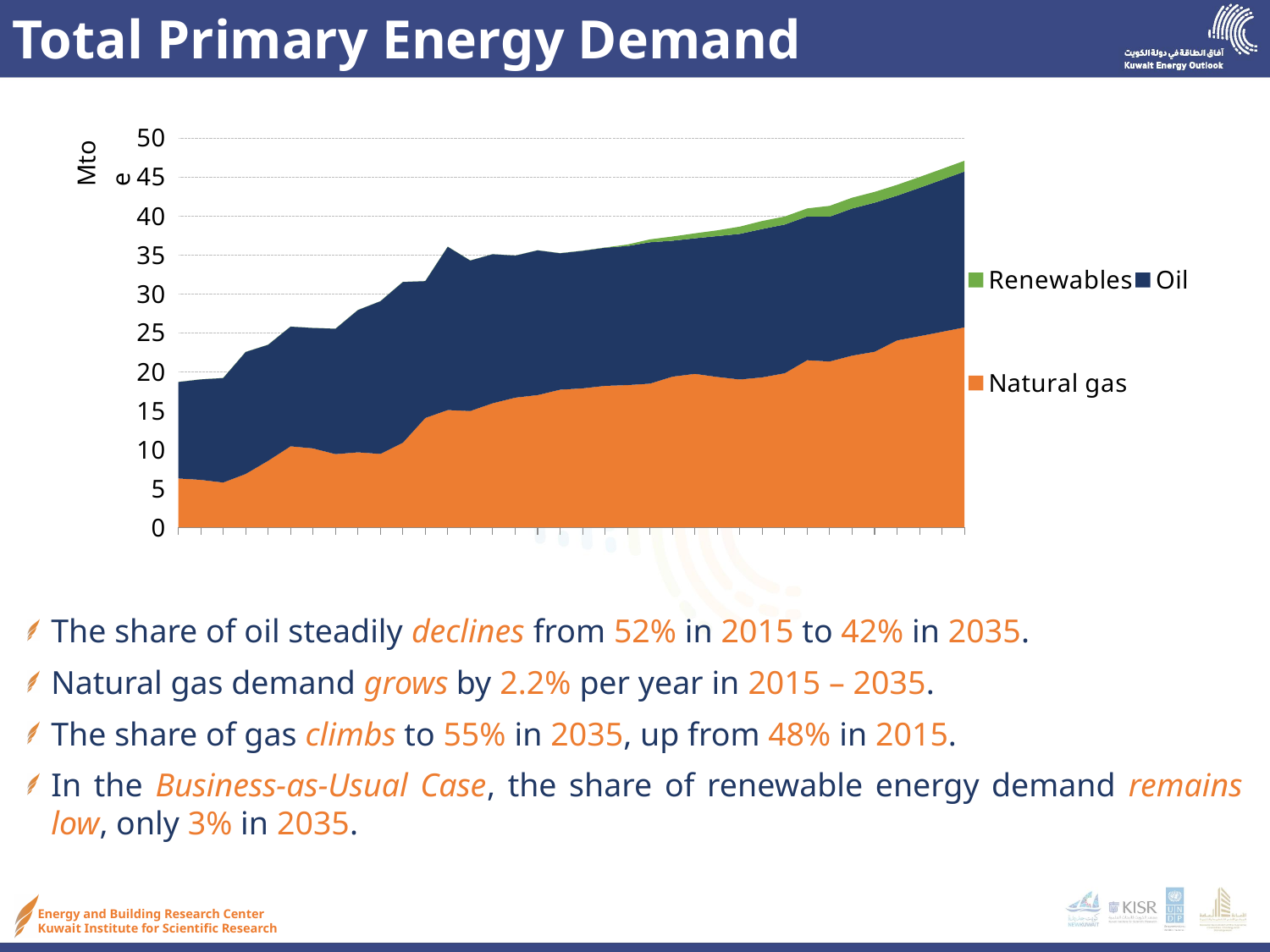
Is the total demand at the left end of the chart greater or less than 25? less At the right end of the chart, which series is larger: Natural gas or Oil? Natural gas What unit is shown on the chart's vertical axis? Mtoe How many series does the chart's legend list? 3 What is the highest value shown on the chart's vertical axis? 50 Is the Natural gas value at the left end of the chart greater or less than 10? less Is the total demand at the right end of the chart greater or less than 45? greater Which series are listed in the chart's legend? Renewables, Oil, Natural gas Does total primary energy demand rise or fall from left to right across the chart? Rise What kind of chart is shown on the slide? Stacked area chart Which series occupies the smallest area in the chart? Renewables